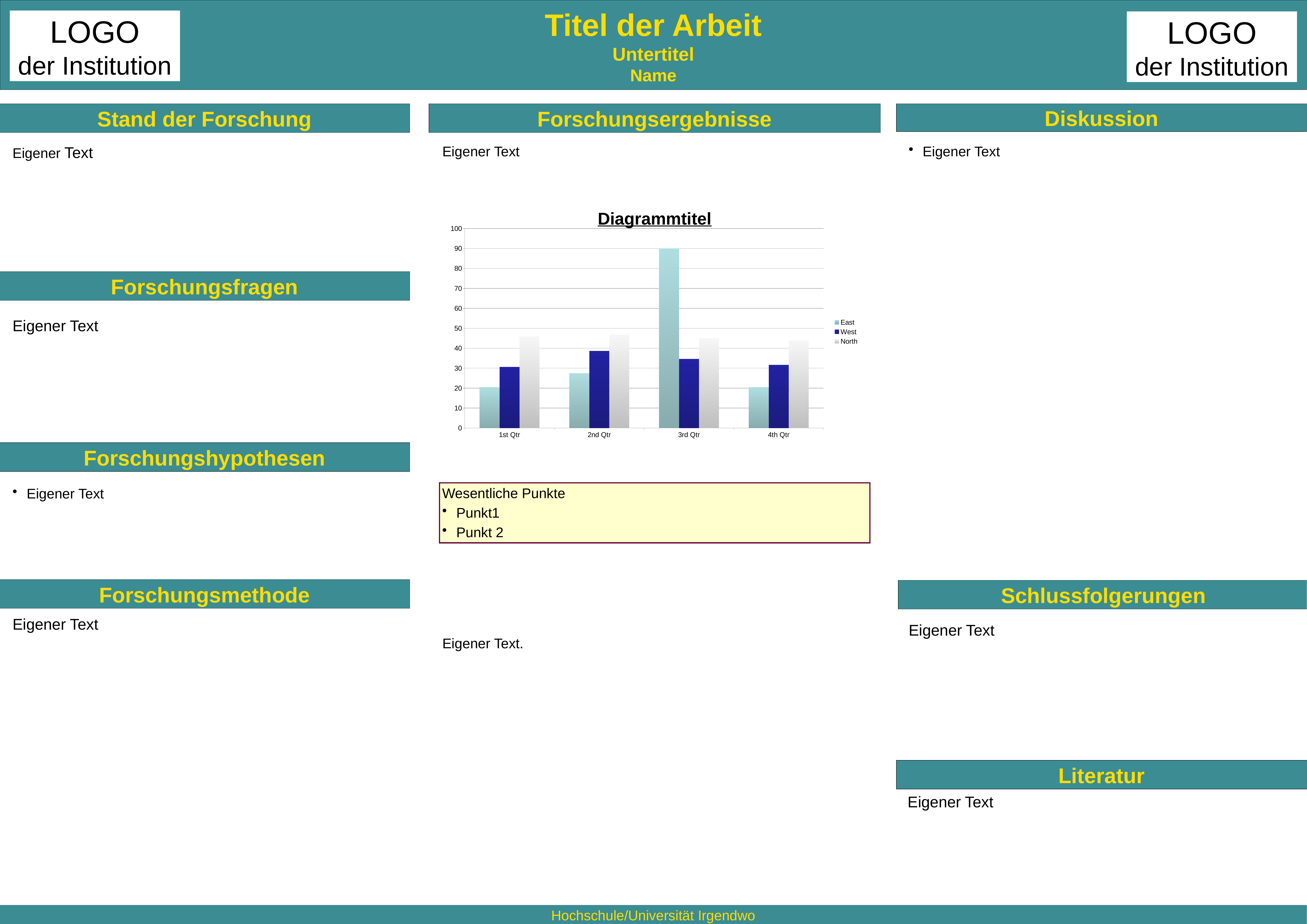
Which series are listed in the chart's legend? East, West, North Is the value for North in 2nd Qtr greater or less than 40? greater Is the value for East in 3rd Qtr greater or less than 80? greater In 3rd Qtr, which series has the larger value, East or West? East Is the value for West in 4th Qtr greater or less than 40? less How many series does the chart's legend list? 3 What is the title of the chart? Diagrammtitel In which quarter is the East series highest? 3rd Qtr What kind of chart is shown on the slide? bar chart How many categories are shown on the x axis of the chart? 4 In 1st Qtr, which series has the larger value, East or North? North